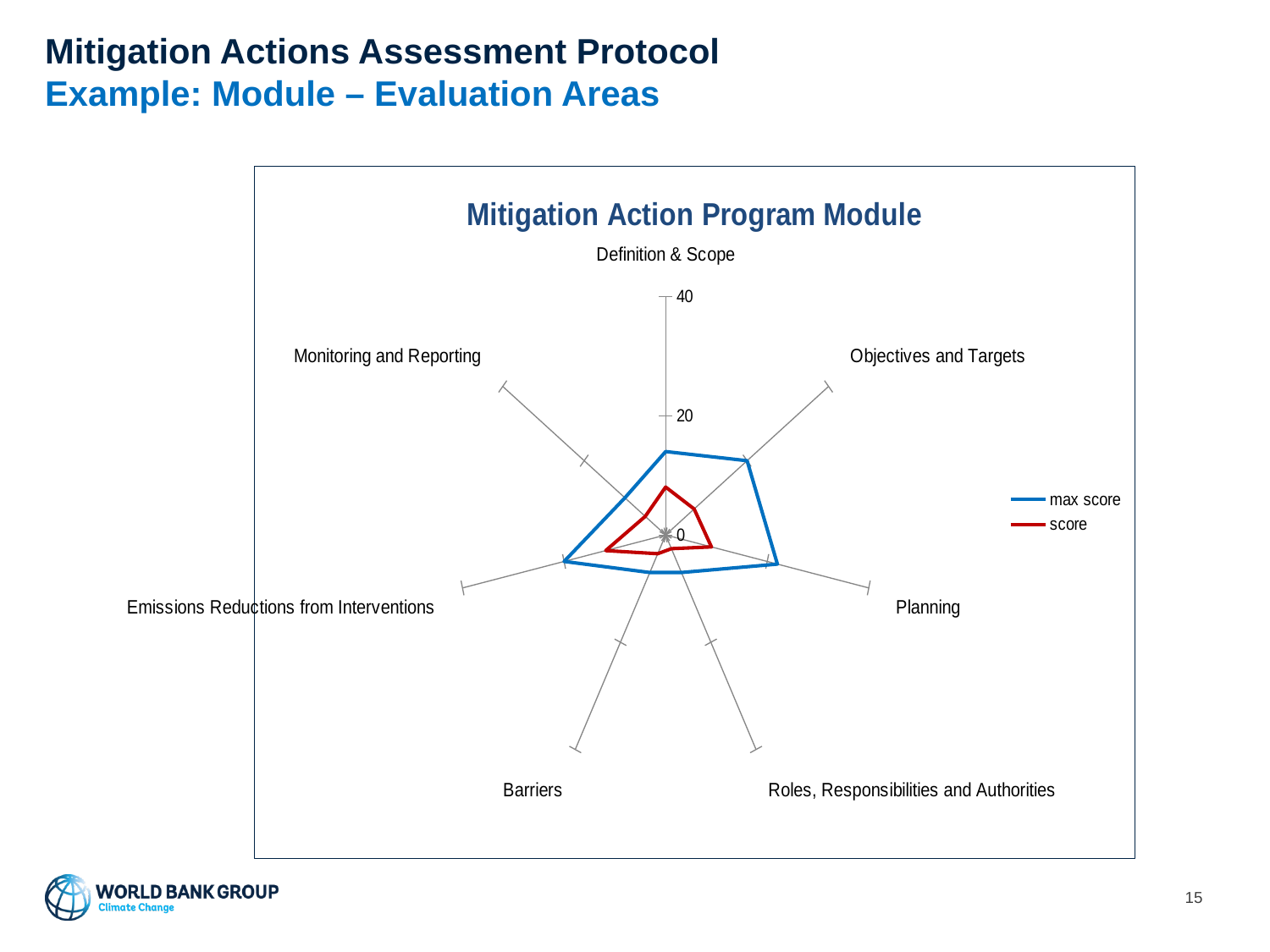
Is the max score for Roles, Responsibilities and Authorities greater or less than 20? less Which series is drawn in red? score Is the max score for Definition & Scope greater or less than 20? less What kind of chart is shown on the slide? Radar chart What is the title of the chart? Mitigation Action Program Module How many series does the legend list? 2 Is the max score for Barriers greater or less than 20? less Which is larger, the max score for Definition & Scope or the max score for Roles, Responsibilities and Authorities? Definition & Scope How many evaluation areas (categories) are plotted on the radar chart? 7 Which is larger, the score for Definition & Scope or the score for Roles, Responsibilities and Authorities? Definition & Scope